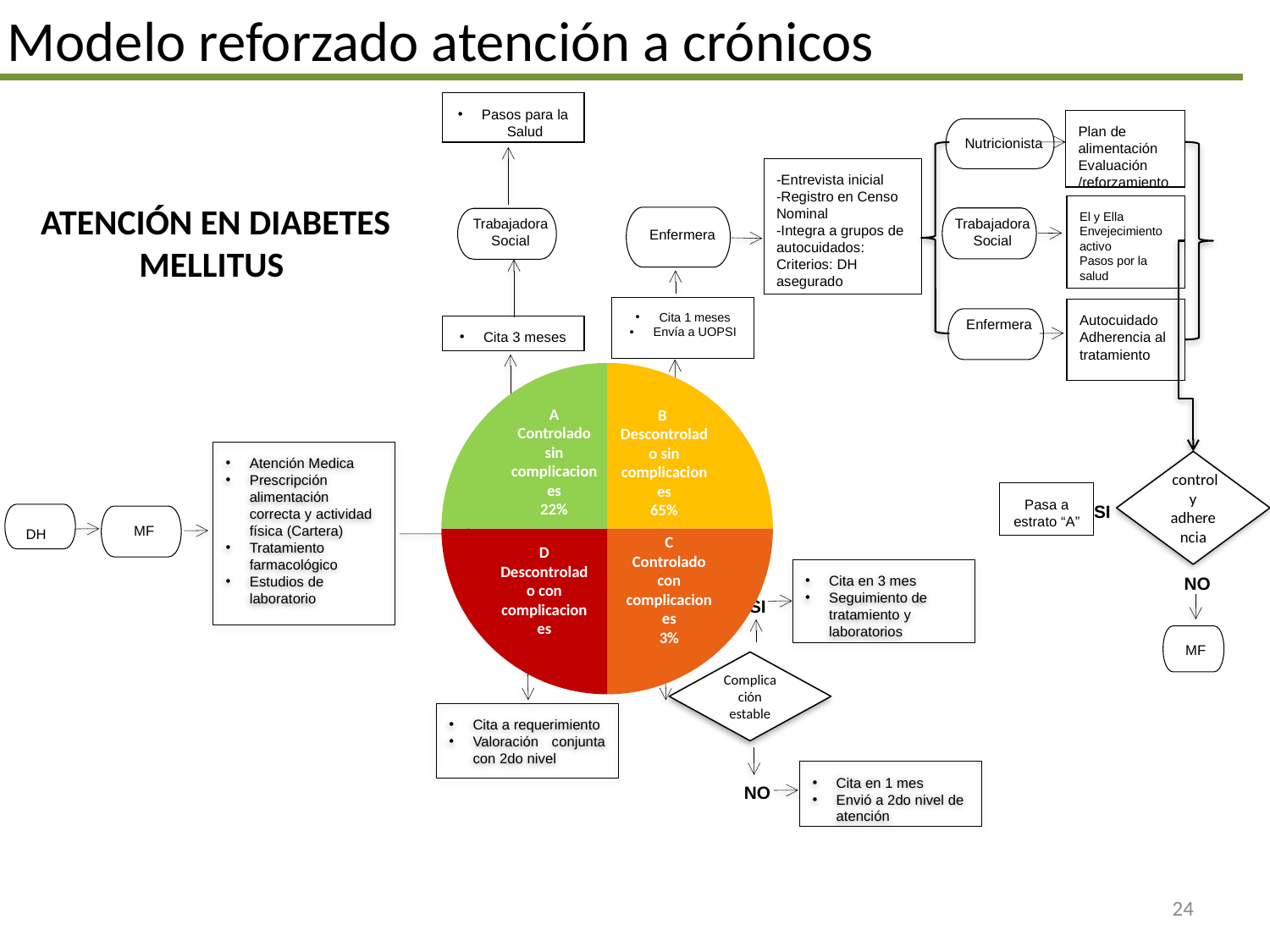
What percentage is printed for segment B, Descontrolado sin complicaciones? 65% How many segments does the pie chart have? 4 What percentage is printed for segment C, Controlado con complicaciones? 3% What percentage is printed for segment A, Controlado sin complicaciones? 22% What is the combined printed percentage of segments A and C? 25% What colour is segment D, Descontrolado con complicaciones, in the pie chart? red What is the difference between the printed percentages for segment B and segment A? 43% According to the printed percentages, which segment of the pie chart has the lowest value? C Controlado con complicaciones Which segment of the pie chart has no percentage printed? D Descontrolado con complicaciones Which has the larger printed percentage, segment A or segment C? A Controlado sin complicaciones What kind of chart is shown in the centre of the slide? pie chart According to the printed percentages, which segment of the pie chart has the highest value? B Descontrolado sin complicaciones